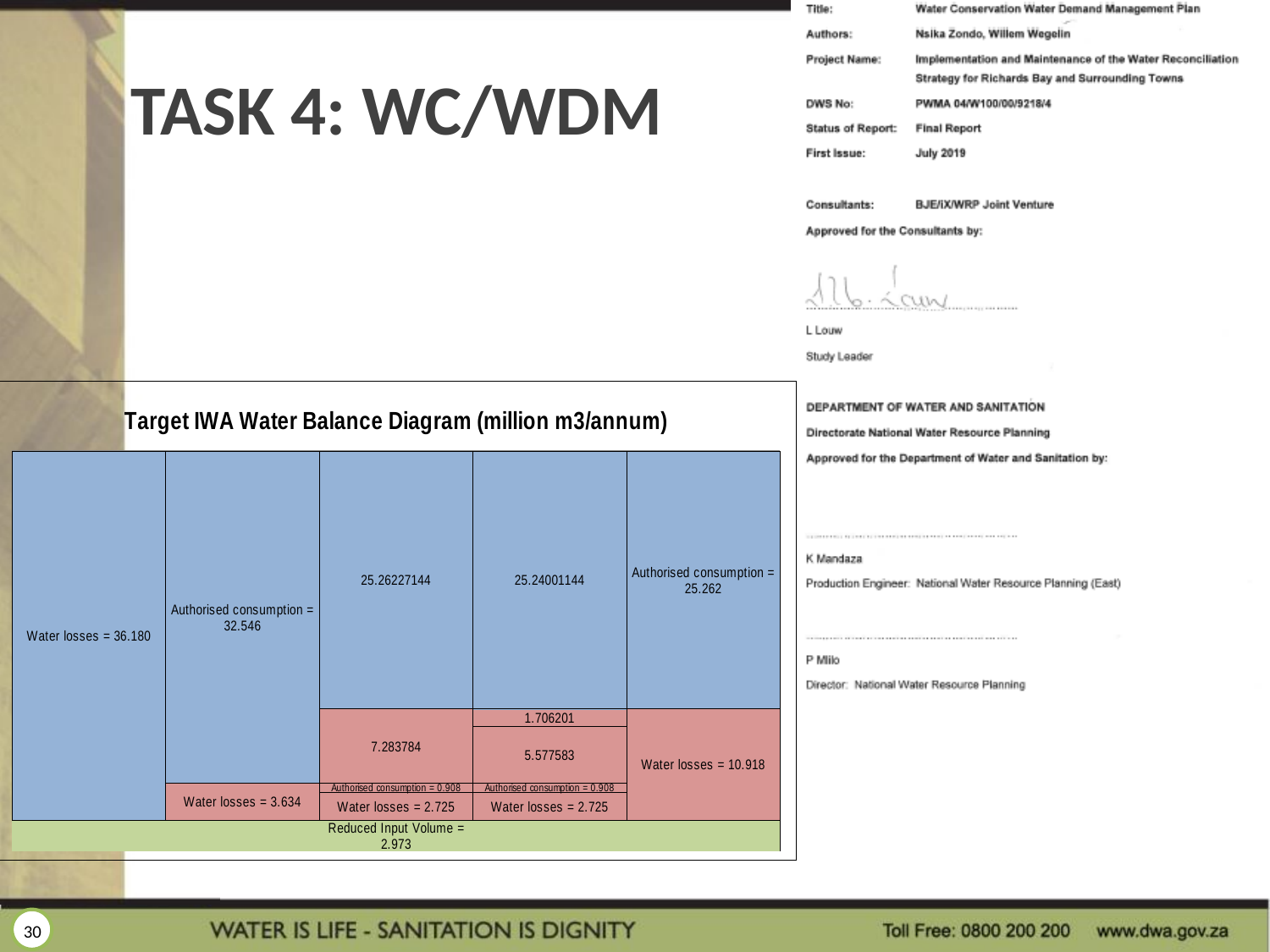
What is the value of Authorised consumption in the second bar from the left of the Target IWA Water Balance Diagram? 32.546 What is the value of Authorised consumption in the rightmost bar of the Target IWA Water Balance Diagram? 25.262 What is the title of the chart on the slide? Target IWA Water Balance Diagram (million m3/annum) What kind of chart is the Target IWA Water Balance Diagram? stacked bar chart What is the value of Water losses in the second bar from the left of the Target IWA Water Balance Diagram? 3.634 In the Target IWA Water Balance Diagram, what is the total of the second bar from the left (Authorised consumption plus Water losses)? 36.180 What is the value of Water losses in the leftmost bar of the Target IWA Water Balance Diagram? 36.180 In the Target IWA Water Balance Diagram, what is the difference between Authorised consumption (25.262) and Water losses (10.918) in the rightmost bar? 14.344 In the Target IWA Water Balance Diagram, which is larger in the rightmost bar: Authorised consumption or Water losses? Authorised consumption What is the Reduced Input Volume shown at the bottom of the Target IWA Water Balance Diagram? 2.973 What is the value of the top blue segment in the middle bar of the Target IWA Water Balance Diagram? 25.26227144 What is the value of Water losses in the rightmost bar of the Target IWA Water Balance Diagram? 10.918